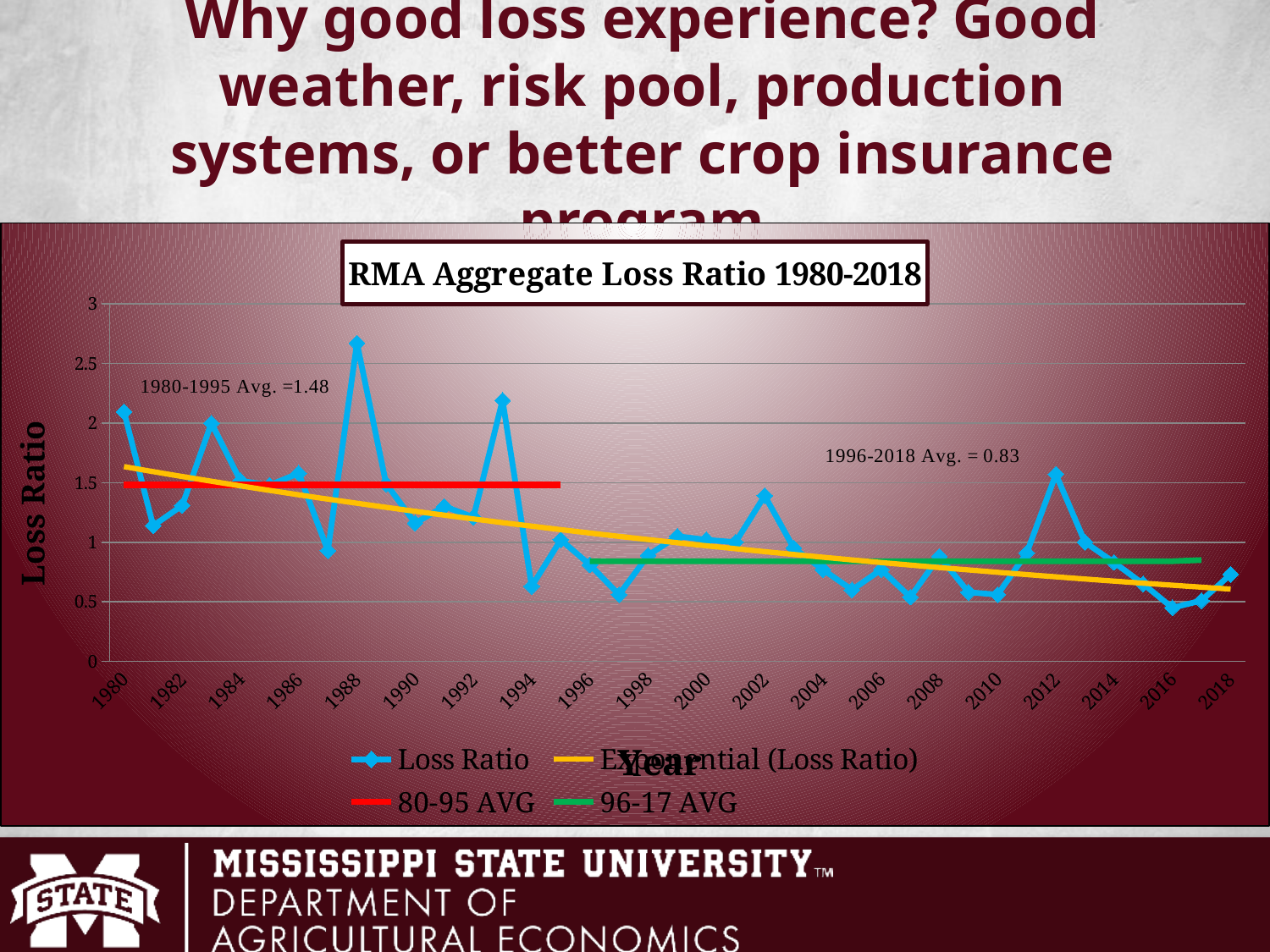
What is the 1980-1995 average loss ratio shown on the chart? 1.48 What type of chart is shown on the slide? line chart Is the loss ratio for 1993 greater or less than 2? greater Is the loss ratio for 2016 greater or less than 1? less What is the 1996-2018 average loss ratio shown on the chart? 0.83 Is the loss ratio for 1988 greater or less than 2.5? greater What is the difference between the 1980-1995 average and the 1996-2018 average loss ratio? 0.65 How many entries does the chart legend list? 4 Does the loss ratio generally rise or fall from 1980 to 2018? fall Which year has the highest loss ratio? 1988 Which is larger, the loss ratio in 1988 or in 1993? 1988 What is the title of the chart? RMA Aggregate Loss Ratio 1980-2018